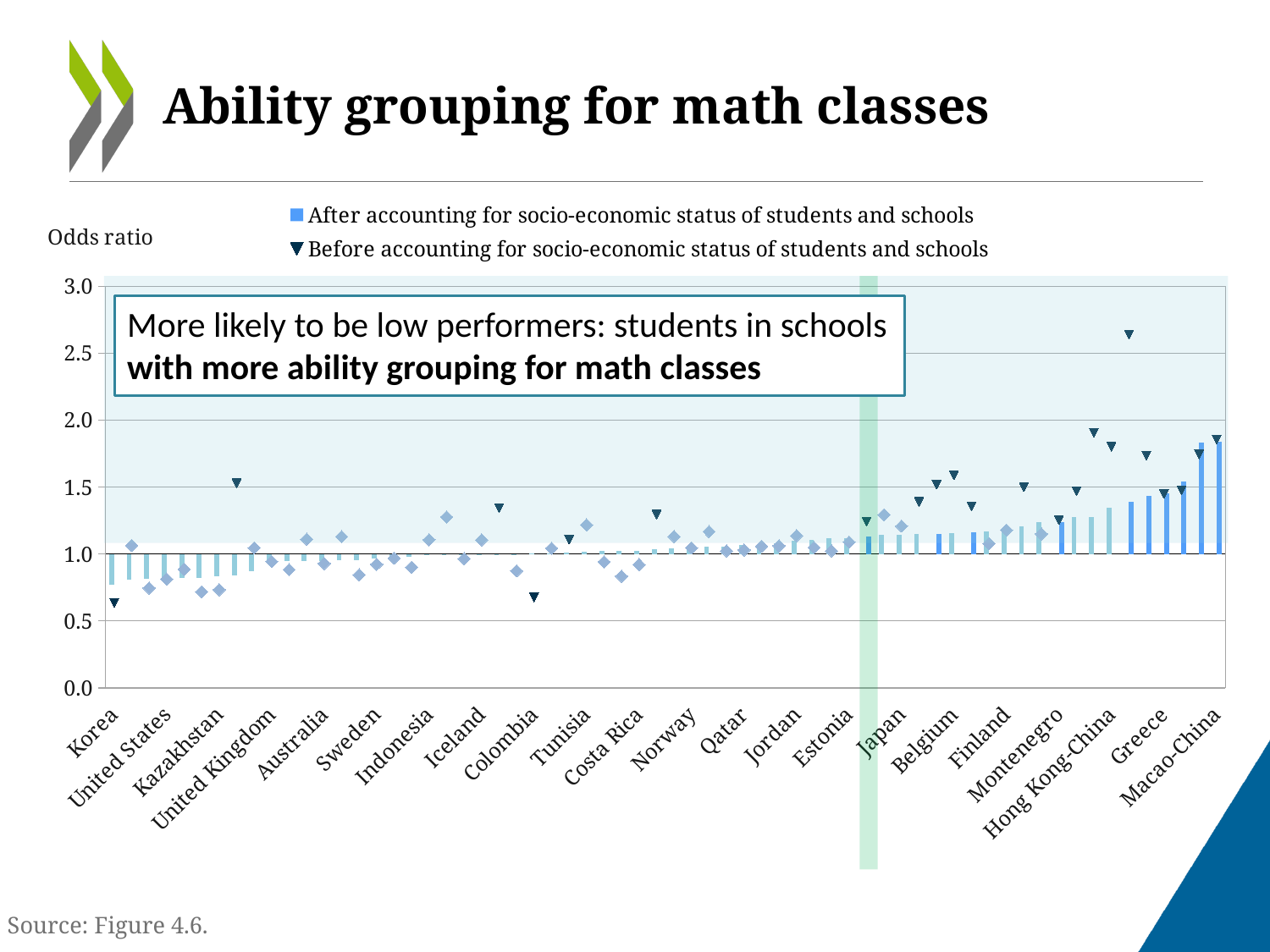
Is the 'After accounting for socio-economic status' bar for Greece greater or less than 1.0? greater Is the 'After accounting for socio-economic status' bar for Macao-China greater or less than 1.5? greater Which country has the highest bar for 'After accounting for socio-economic status of students and schools'? Macao-China What kind of chart is shown on the slide? Bar chart Which has the larger 'After accounting for socio-economic status' bar, Korea or Macao-China? Macao-China Is the 'Before accounting for socio-economic status' marker for Hong Kong-China greater or less than 1.5? greater How many series does the legend list? 2 What quantity does the vertical axis measure, according to the axis label? Odds ratio What is the title of the slide's chart? Ability grouping for math classes Do the 'After accounting for socio-economic status' bars generally rise or fall from left to right along the x axis? Rise